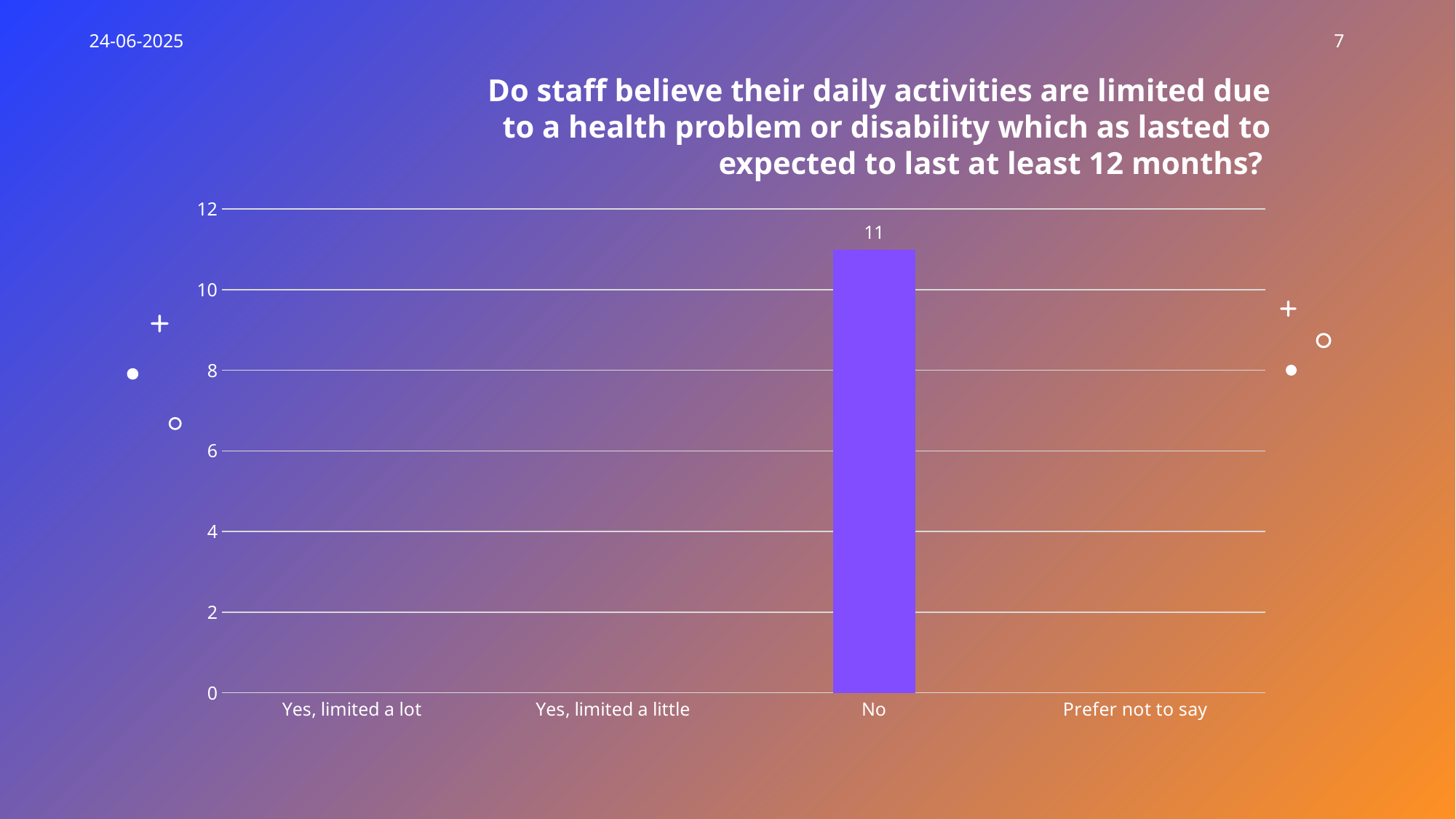
How many categories are shown on the x axis? 4 What kind of chart is shown on the slide? Bar chart What is the label of the third category on the x axis? No Which category has the highest value? No Is the value for "No" greater or less than 10? greater Which is larger, the value for "No" or the value for "Prefer not to say"? No Is the value for "No" greater or less than 12? less What is the value for the "No" category? 11 What is the maximum value shown on the y axis? 12 How many categories have a visible bar in the chart? 1 Which is larger, the value for "No" or the value for "Yes, limited a lot"? No